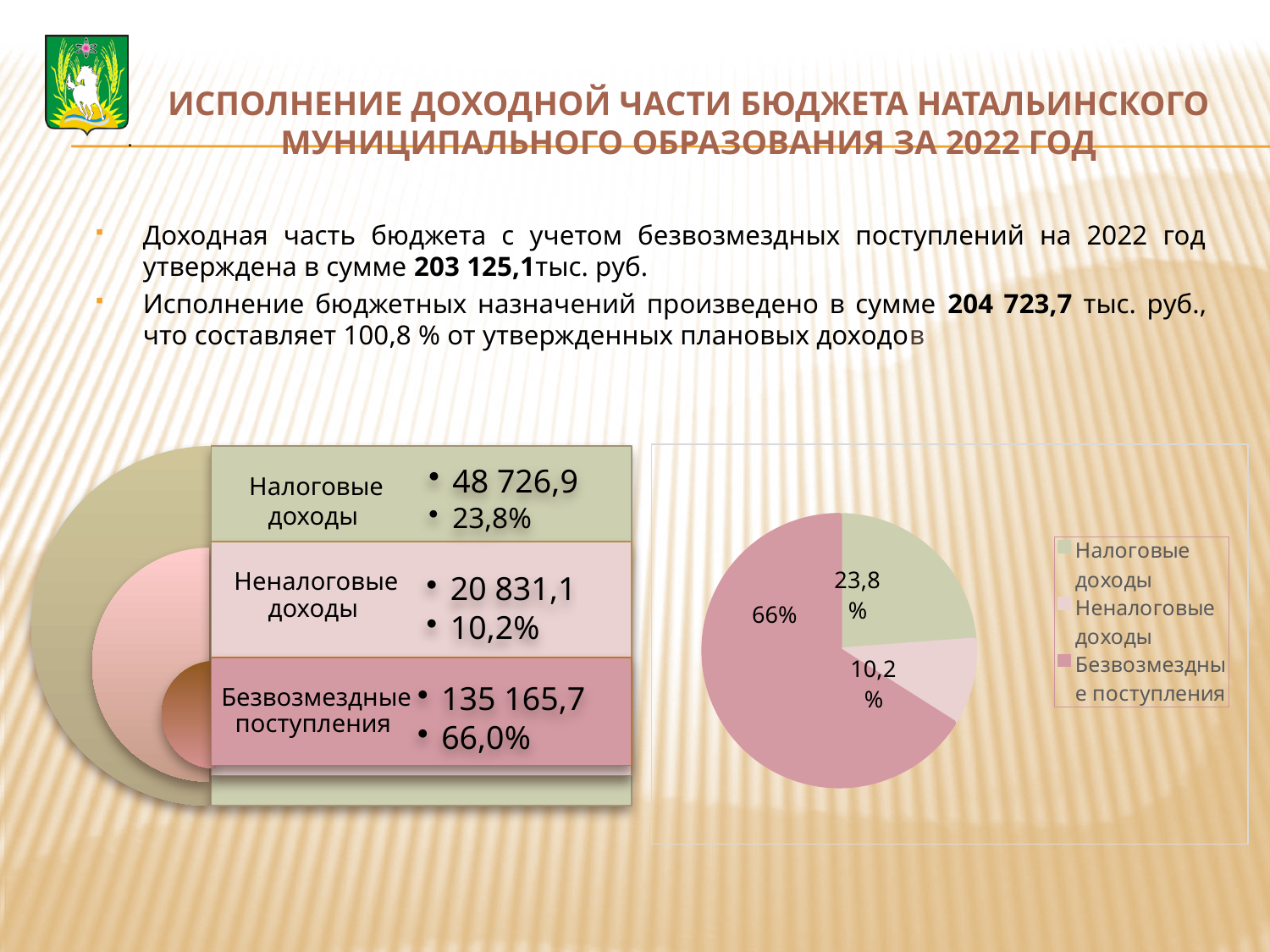
In the pie chart, what share is shown for Неналоговые доходы? 10,2% How many slices does the pie chart have? 3 How many entries does the legend of the pie chart list? 3 In the pie chart, what is the difference in percentage points between Безвозмездные поступления and Налоговые доходы? 42,2 In the pie chart, what is the difference in percentage points between Налоговые доходы and Неналоговые доходы? 13,6 In the pie chart, which is larger: Налоговые доходы or Неналоговые доходы? Налоговые доходы In the pie chart, what share is shown for Безвозмездные поступления? 66% What kind of chart is shown on the right side of the slide? pie chart Which slice of the pie chart is the smallest? Неналоговые доходы Which slice of the pie chart is the largest? Безвозмездные поступления Which legend entry of the pie chart is shown in the darker pink colour? Безвозмездные поступления In the pie chart, what share is shown for Налоговые доходы? 23,8%